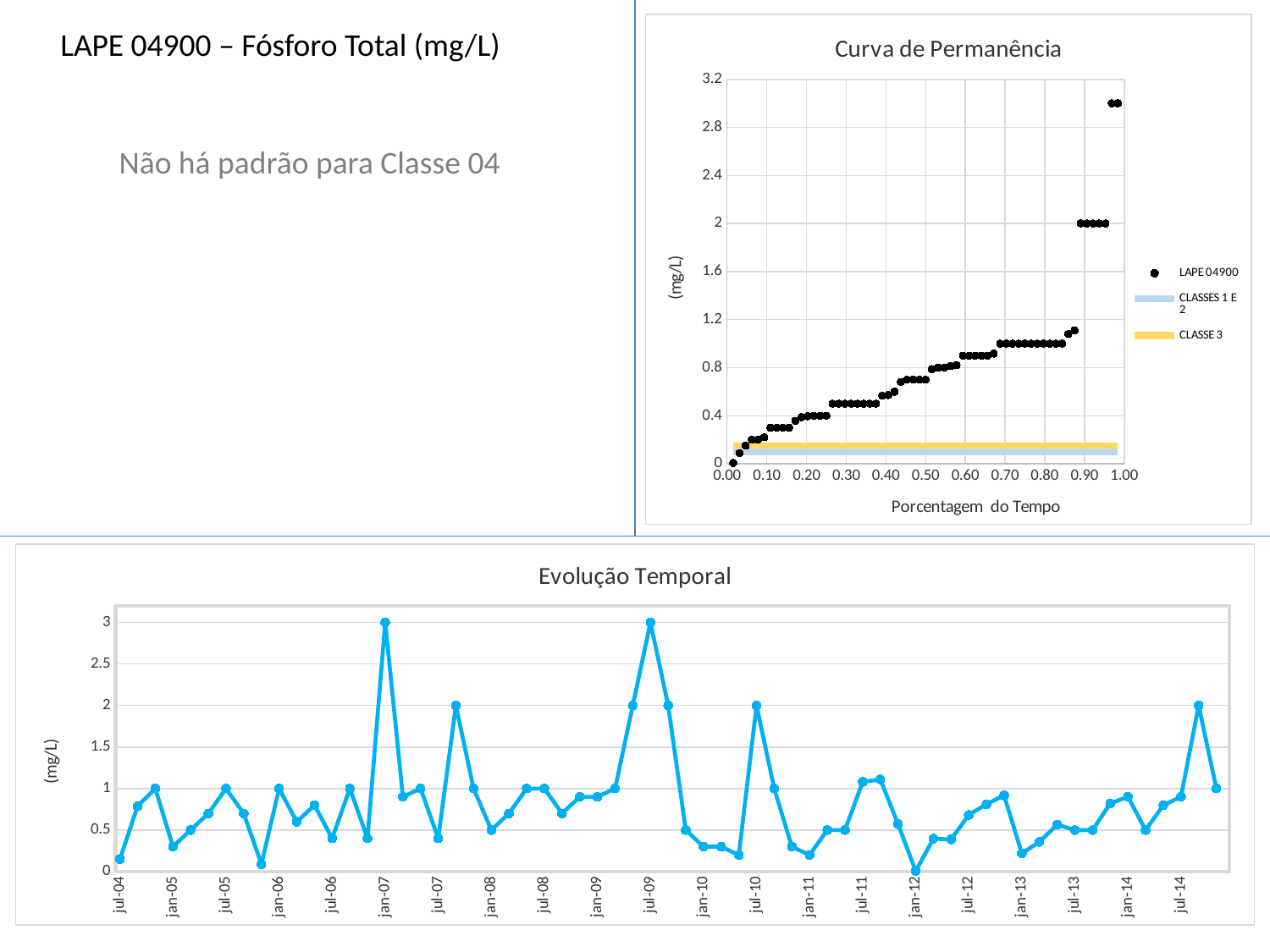
In the 'Curva de Permanência' chart, do the LAPE 04900 values rise or fall along the x axis? rise How many series does the legend of the 'Curva de Permanência' chart list? 3 In the 'Curva de Permanência' chart, is the LAPE 04900 value at 0.50 on the x axis greater or less than 0.4? greater What kind of chart is the 'Evolução Temporal' chart? line chart In the 'Evolução Temporal' chart, is the value at jan-12 greater or less than 0.5? less In the 'Evolução Temporal' chart, what is the highest value reached? 3 In the 'Evolução Temporal' chart, which is larger, the value at jan-07 or the value at jul-10? jan-07 In the 'Evolução Temporal' chart, what is the value at jul-09? 3 What are the legend entries of the 'Curva de Permanência' chart? LAPE 04900, CLASSES 1 E 2, CLASSE 3 What is the x-axis title of the 'Curva de Permanência' chart? Porcentagem do Tempo In the 'Evolução Temporal' chart, what is the value at jan-07? 3 In the 'Evolução Temporal' chart, what is the value at jul-10? 2